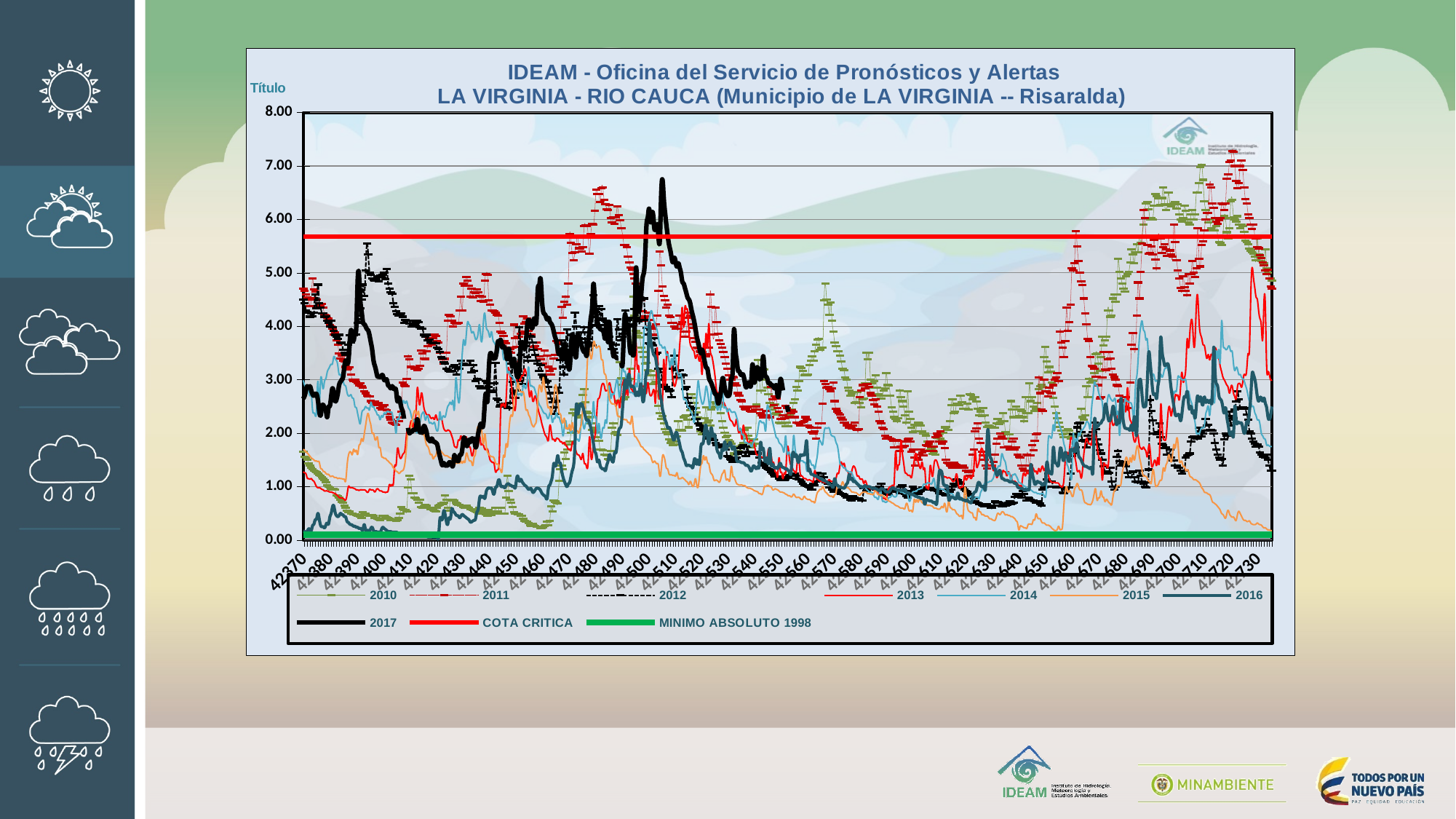
Is the peak value of the 2017 series greater or less than 6.00? greater Is the COTA CRITICA line greater or less than 5.00? greater At x = 42500, which series has the larger value, 2017 or 2015? 2017 What is the highest value shown on the y axis? 8.00 How many series does the legend list? 10 Does the 2015 series rise or fall between 42690 and 42730? fall Is the COTA CRITICA line greater or less than 6.00? less What kind of chart is shown on the slide? line chart Which series reaches the highest value on the chart, 2017 or 2016? 2017 Which legend entry is drawn as a solid red horizontal line across the chart? COTA CRITICA